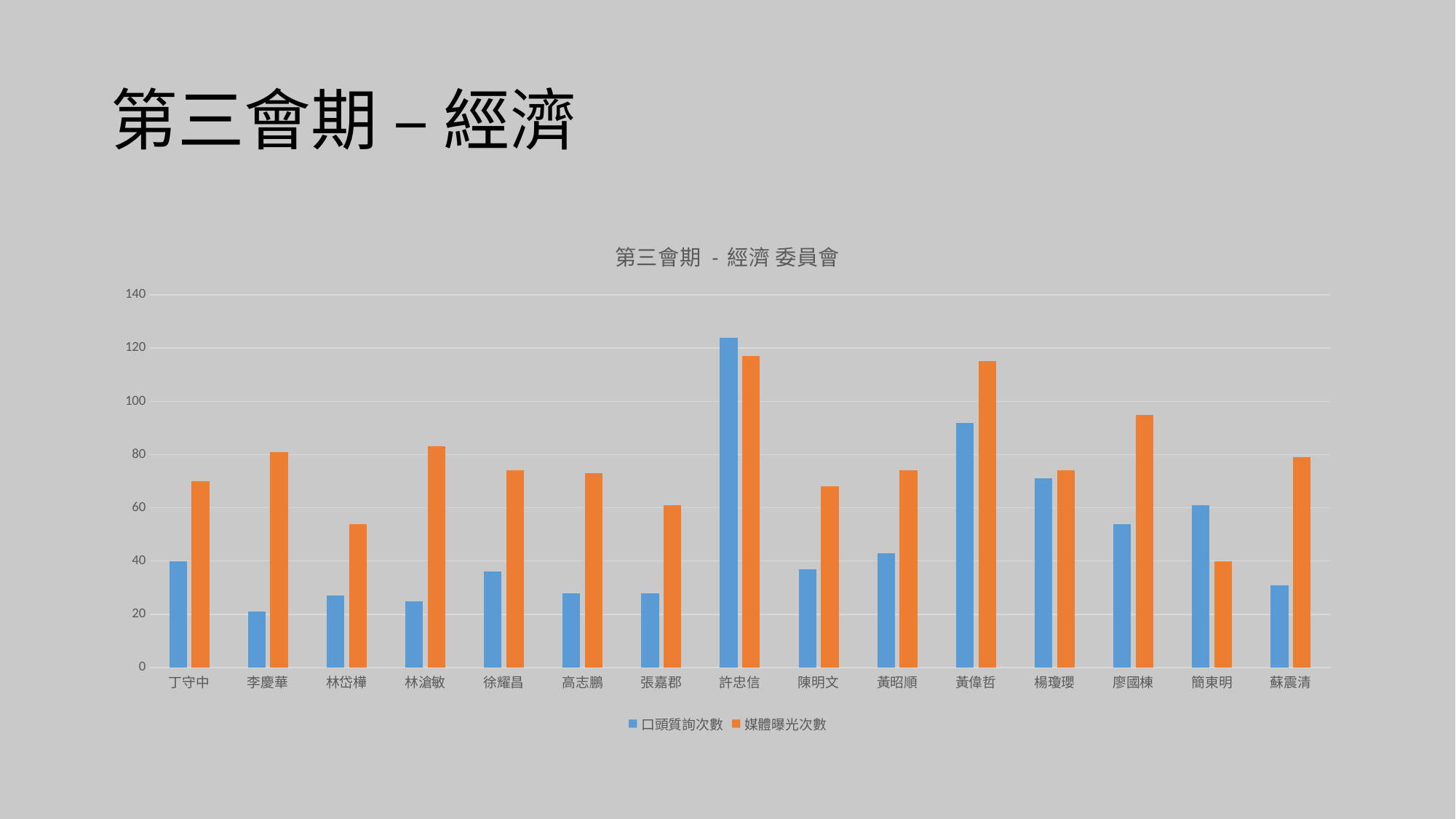
For 丁守中, which is larger: 口頭質詢次數 or 媒體曝光次數? 媒體曝光次數 Is the 媒體曝光次數 value for 廖國棟 greater or less than 80? greater What is the title of the chart? 第三會期 - 經濟 委員會 Is the 口頭質詢次數 value for 許忠信 greater or less than 100? greater Which legislator has the lowest 口頭質詢次數? 李慶華 Is the 口頭質詢次數 value for 李慶華 greater or less than 40? less Which legislator has the highest 口頭質詢次數? 許忠信 How many legislators (categories) are shown on the x axis? 15 What type of chart is shown on the slide? bar chart How many series does the legend list? 2 Which legislator has the lowest 媒體曝光次數? 簡東明